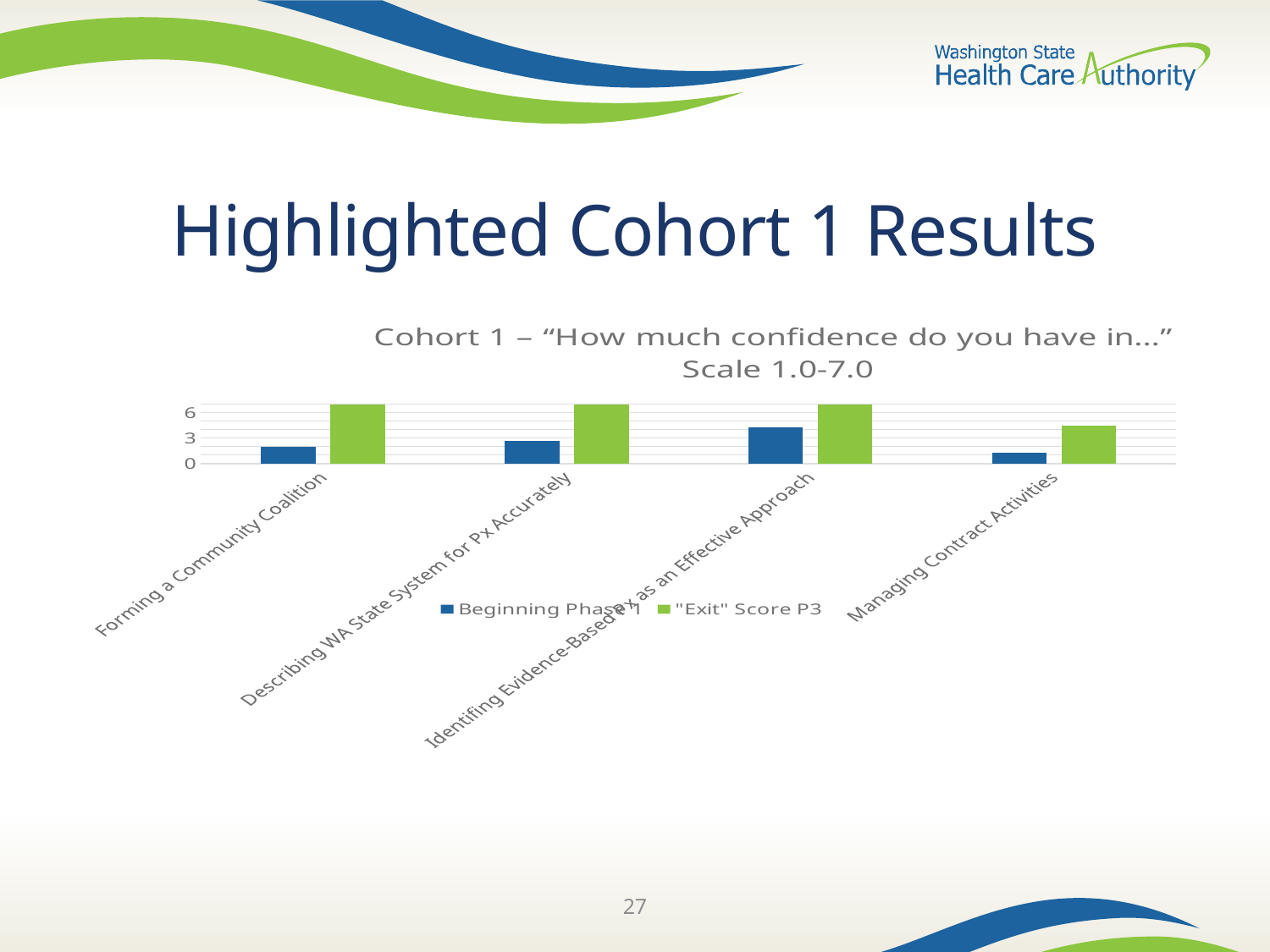
What kind of chart is shown on the slide? Bar chart Which is larger for Managing Contract Activities: the Beginning Phase 1 value or the "Exit" Score P3 value? "Exit" Score P3 How many series does the chart's legend list? 2 What are the two series named in the chart's legend? Beginning Phase 1 and "Exit" Score P3 Is the "Exit" Score P3 value for Managing Contract Activities greater or less than 3? greater Which category has the highest Beginning Phase 1 value? Identifying Evidence-Based Px as an Effective Approach Which category has the lowest Beginning Phase 1 value? Managing Contract Activities How many categories are shown on the x axis of the chart? 4 Is the Beginning Phase 1 value for Identifying Evidence-Based Px as an Effective Approach greater or less than 3? greater What scale does the chart's title say the confidence ratings use? Scale 1.0-7.0 Is the Beginning Phase 1 value for Forming a Community Coalition greater or less than 3? less Which has the larger Beginning Phase 1 value: Forming a Community Coalition or Identifying Evidence-Based Px as an Effective Approach? Identifying Evidence-Based Px as an Effective Approach